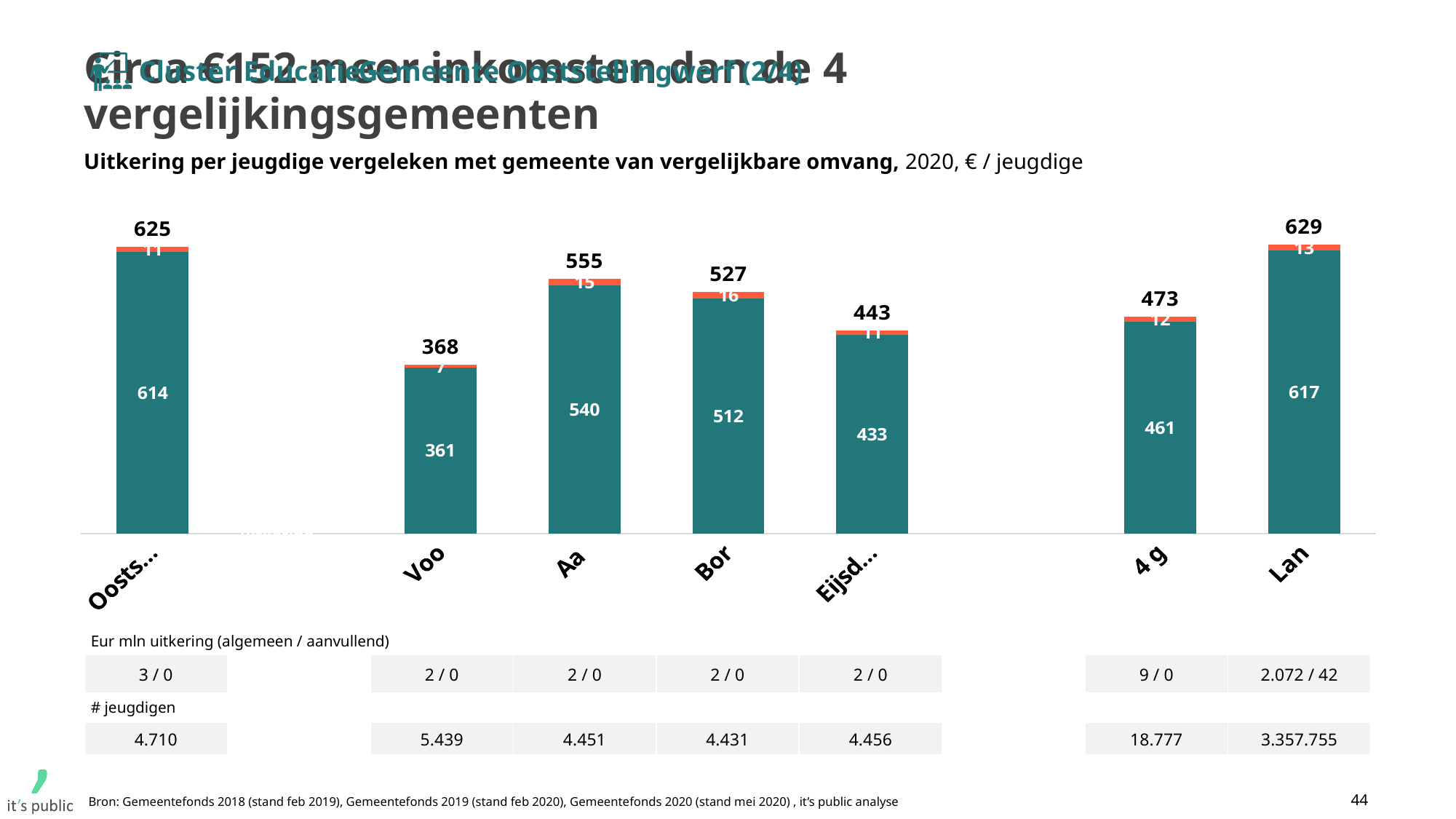
In what unit are the chart values expressed, according to the subtitle? € / jeugdige What kind of chart is shown on the slide? Stacked bar chart What is the difference between the totals for Aa (555) and Bor (527)? 28 What is the total value shown above the bar for Voo? 368 Which has a larger total value, Bor or 4 g? Bor What value is printed inside the teal segment of the Lan bar? 617 What is the total value shown above the bar for 4 g? 473 Which category has the highest total value? Lan What is the difference between the total for Oosts... (625) and the total for Eijsd... (443)? 182 Which category has the lowest total value? Voo How many bars are shown in the chart? 7 What value is printed inside the large teal segment of the Aa bar? 540